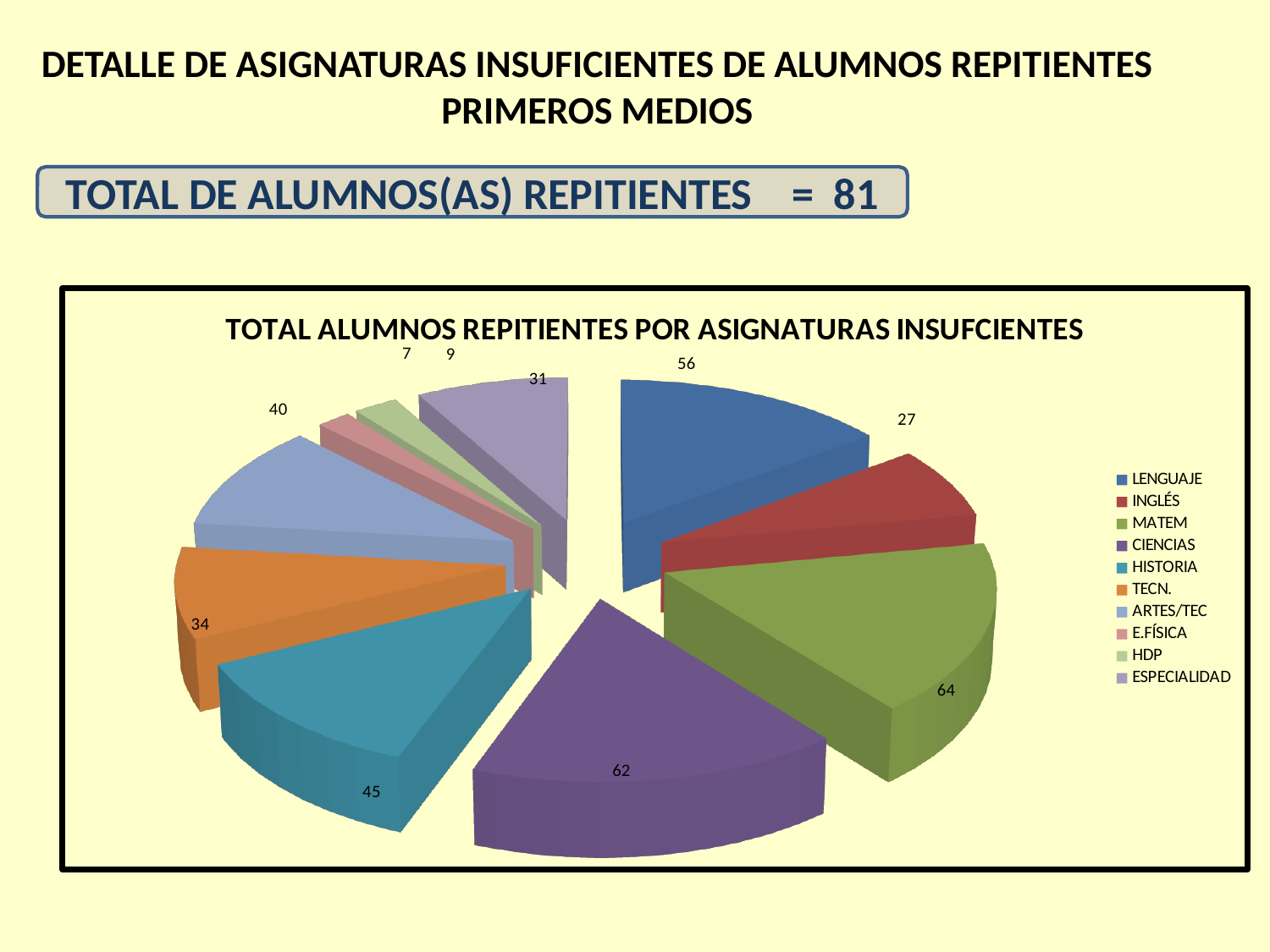
What is the value for ESPECIALIDAD in the pie chart? 31 How many subjects are listed in the legend of the pie chart? 10 What is the value for HISTORIA in the pie chart? 45 What is the title of the chart? TOTAL ALUMNOS REPITIENTES POR ASIGNATURAS INSUFCIENTES What is the difference between the values for MATEM and CIENCIAS? 2 What is the value for TECN. in the pie chart? 34 What is the difference between the values for LENGUAJE and INGLÉS? 29 Which subject has the largest slice in the pie chart? MATEM Which is larger, the value for ARTES/TEC or the value for TECN.? ARTES/TEC Which subject has the smallest slice in the pie chart? E.FÍSICA What is the value for LENGUAJE in the pie chart? 56 What kind of chart is shown on the slide? Pie chart